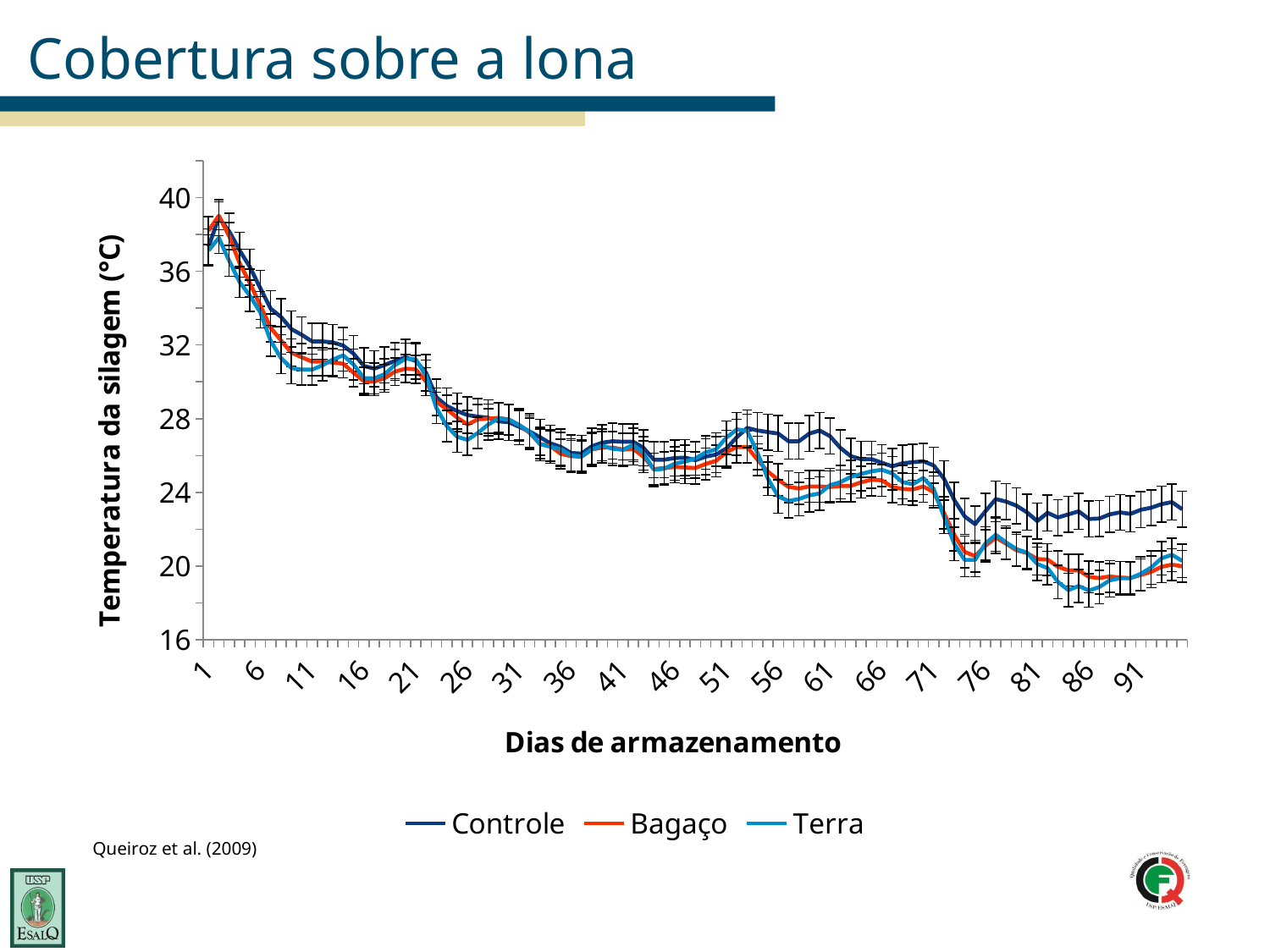
Do the temperature values generally rise or fall as the days of storage increase? fall How many series does the legend list? 3 Which series are listed in the legend? Controle, Bagaço, Terra At day 61, which series has the higher value, Controle or Bagaço? Controle At day 91, which series has the higher value, Controle or Terra? Controle Is the value for Terra at day 86 greater or less than 20? less Is the value for Controle at day 1 greater or less than 36? greater What kind of chart is shown on the slide? line chart Is the value for Controle at day 61 greater or less than 24? greater Which series has the highest value at day 76? Controle What is the label of the y axis? Temperatura da silagem (°C)